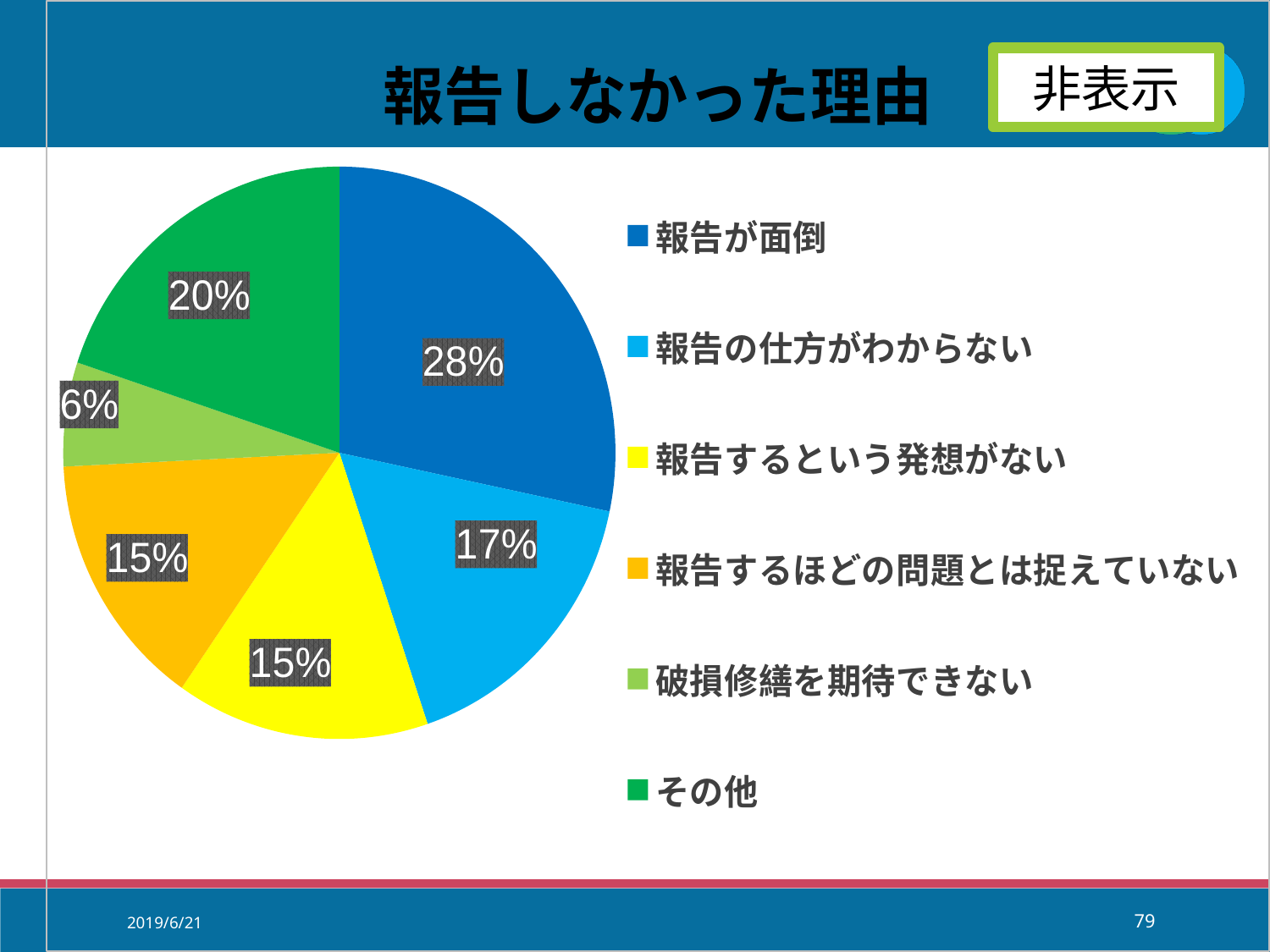
What is the difference between the shares of 報告が面倒 and その他? 8% What is the title of the chart? 報告しなかった理由 What share of the pie does 破損修繕を期待できない have? 6% Which has a larger share, 報告の仕方がわからない or その他? その他 What share of the pie does 報告が面倒 have? 28% What kind of chart is shown on the slide? pie chart What colour is the slice for 報告するという発想がない? yellow Which category has the smallest share of the pie? 破損修繕を期待できない Which category has the largest share of the pie? 報告が面倒 What share of the pie does 報告の仕方がわからない have? 17% How many categories does the pie chart have? 6 What share of the pie does その他 have? 20%